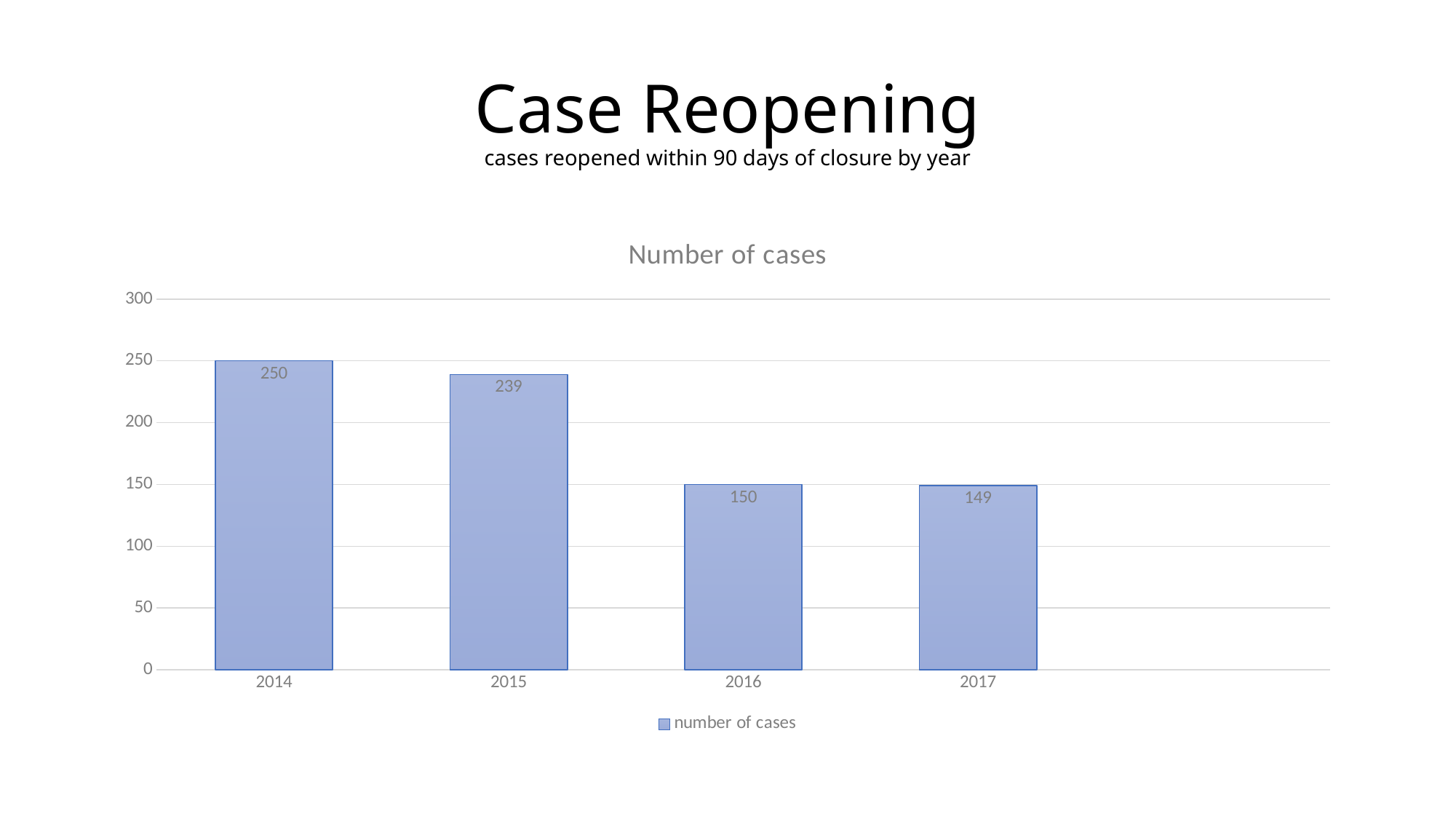
What is the difference in number of cases between 2015 and 2016? 89 How many years are shown on the x axis? 4 What is the number of cases for 2017? 149 What is the difference in number of cases between 2014 and 2017? 101 Which year has the highest number of cases? 2014 What is the number of cases for 2016? 150 What is the number of cases for 2014? 250 What is the number of cases for 2015? 239 How many series does the legend list? 1 Do the number of cases rise or fall from 2014 to 2017? Fall Which year has more cases, 2015 or 2016? 2015 What kind of chart is shown on the slide? Bar chart